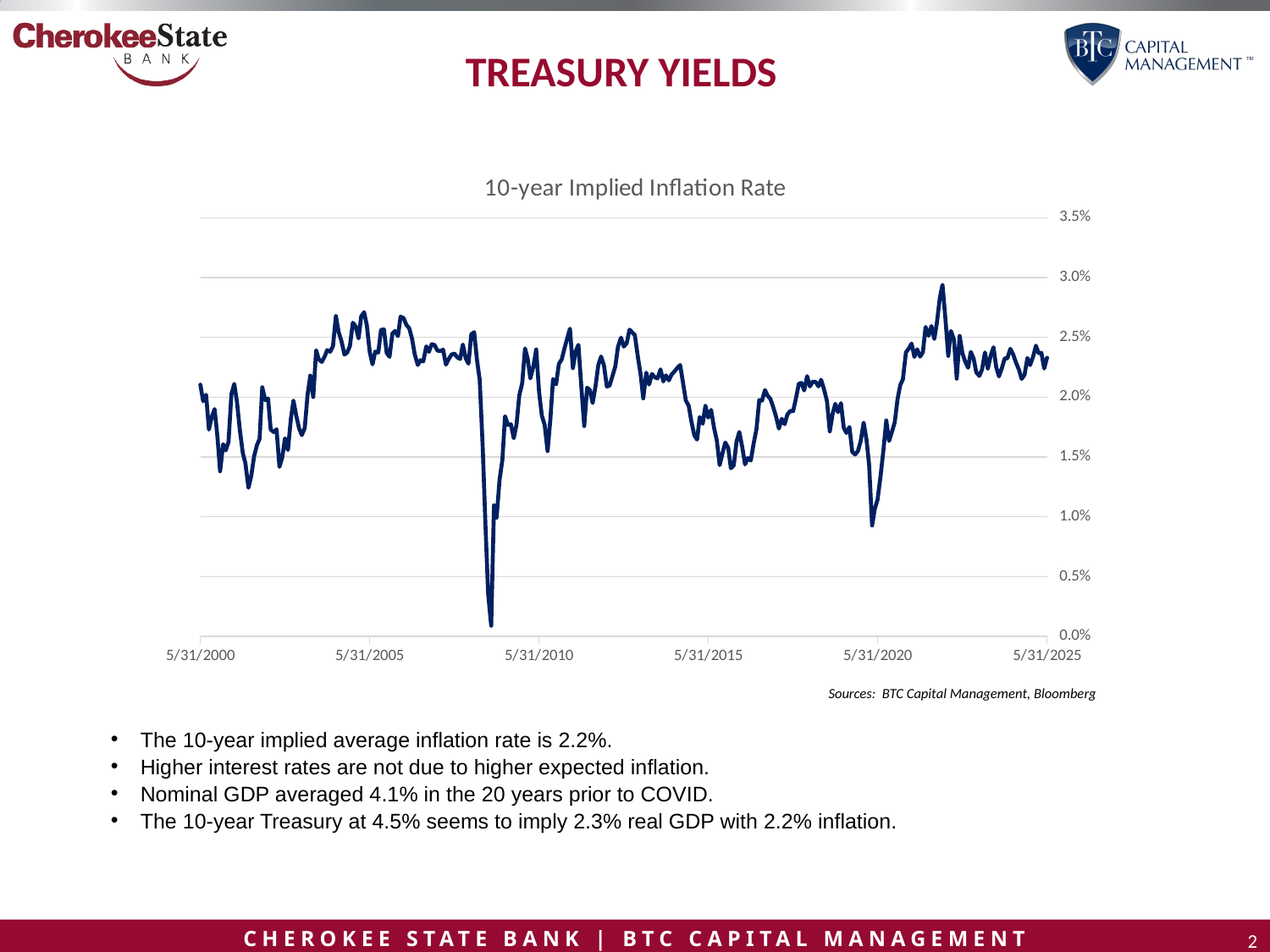
What is the title of the chart? 10-year Implied Inflation Rate Is the lowest point of the line (around 2008) greater or less than 0.5%? less What is the highest value shown on the y axis of the chart? 3.5% What kind of chart is shown on the slide? line chart Is the highest point of the line (around 2022) greater or less than 2.5%? greater Is the value at 5/31/2025 greater or less than 2.5%? less Between 5/31/2020 and 5/31/2025, does the line overall rise or fall? rise Between 5/31/2000 and 5/31/2005, does the line overall rise or fall? rise How many date labels are shown on the x axis of the chart? 6